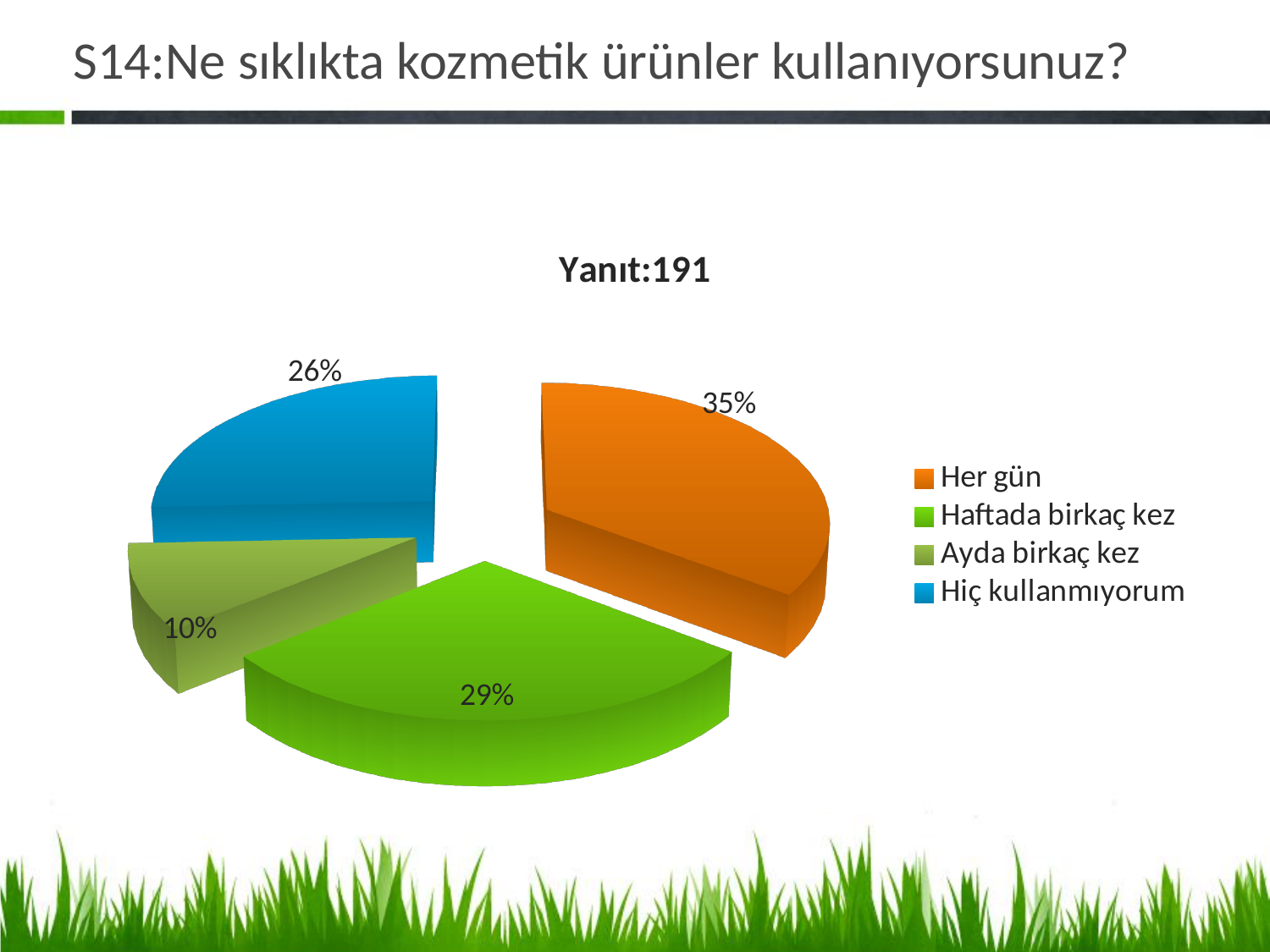
What share of the pie does "Hiç kullanmıyorum" have? 26% What kind of chart is shown on the slide? pie chart What share of the pie does "Haftada birkaç kez" have? 29% What colour is the slice for "Hiç kullanmıyorum"? blue Which is larger, the share for "Haftada birkaç kez" or the share for "Hiç kullanmıyorum"? Haftada birkaç kez How many categories does the legend list? 4 Which category has the largest slice? Her gün What share of the pie does "Ayda birkaç kez" have? 10% Which category has the smallest slice? Ayda birkaç kez What is the chart's title? Yanıt:191 What is the difference between the shares for "Her gün" and "Hiç kullanmıyorum"? 9%